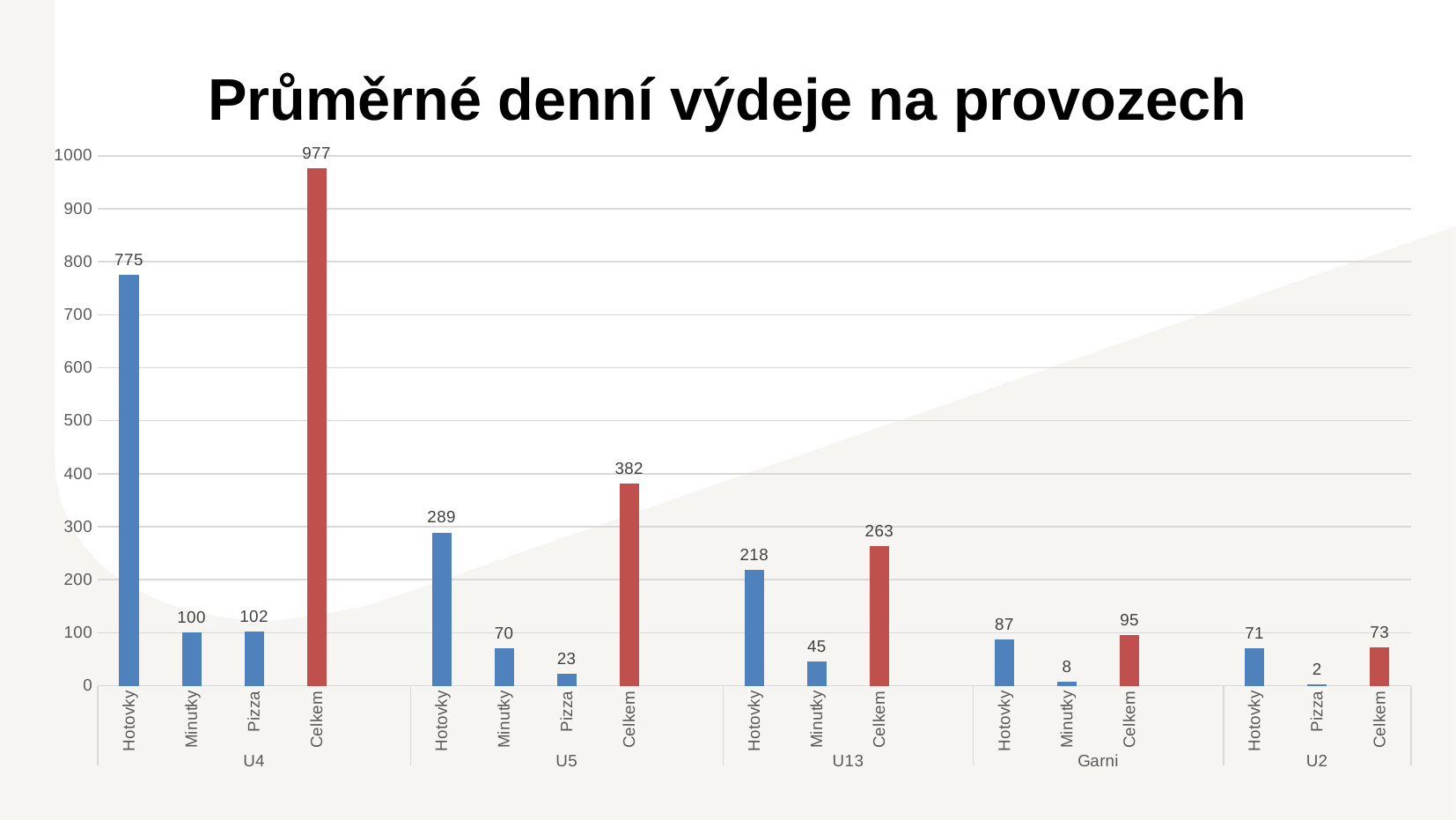
What is the difference between the Celkem values for U4 and U5? 595 Which group has the lowest Celkem value? U2 What is the value for Hotovky in the U4 group? 775 How many groups (provozy) are shown on the x axis? 5 Is the value for Hotovky in the U4 group greater or less than 700? greater What is the value for Pizza in the U2 group? 2 What is the value for Minutky in the Garni group? 8 What kind of chart is shown on the slide? Bar chart What is the value for Celkem in the U5 group? 382 Which group has the highest Celkem value? U4 Which is larger: Hotovky in U13 or Hotovky in U5? Hotovky in U5 What is the title of the chart? Průměrné denní výdeje na provozech